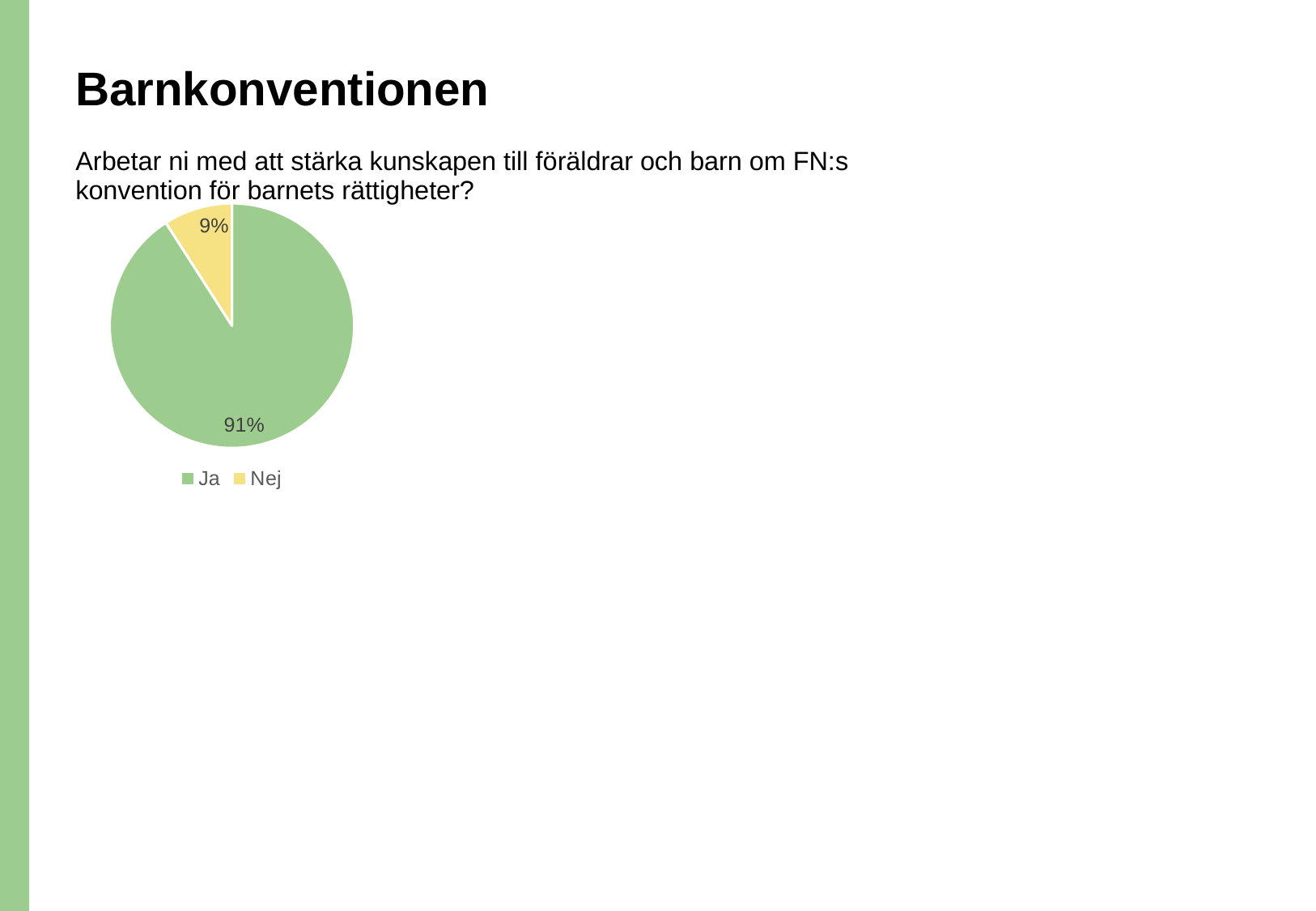
What kind of chart is shown on the slide? Pie chart What is the difference in percentage points between the "Ja" and "Nej" slices? 82 How many slices does the pie chart have? 2 What colour is the "Nej" slice? Yellow How many entries does the legend list? 2 Which category has the largest slice of the pie? Ja What is the title of the slide? Barnkonventionen What share of the pie does "Ja" represent? 91% Which slice is larger, "Ja" or "Nej"? Ja Which category has the smallest slice of the pie? Nej What share of the pie does "Nej" represent? 9%